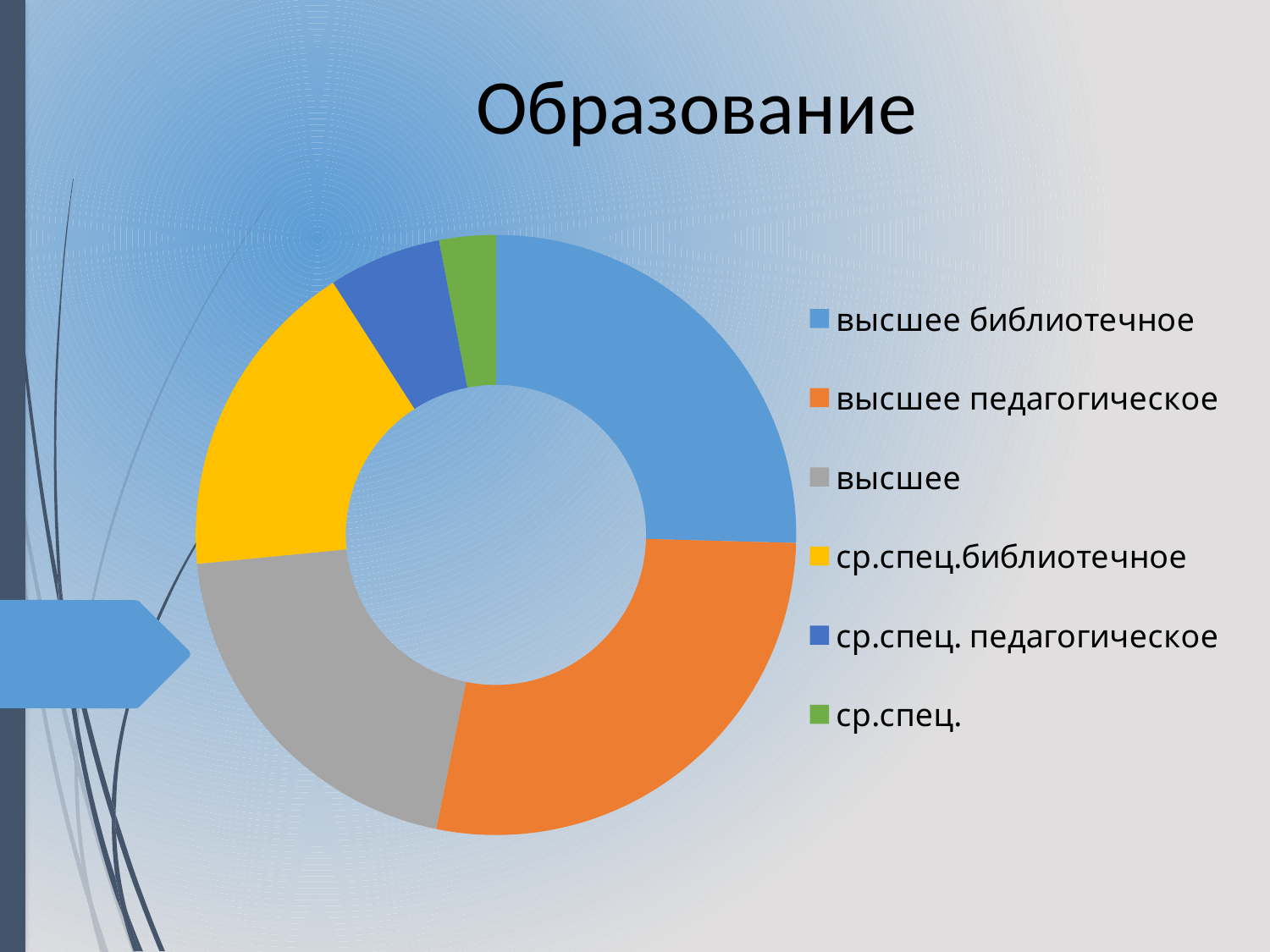
Which slice is larger: высшее педагогическое or высшее? высшее педагогическое What is the title of the chart? Образование What colour represents the category ср.спец.библиотечное in the chart? yellow What kind of chart is shown on the slide? doughnut (pie) chart Which slice is larger: ср.спец. педагогическое or ср.спец.? ср.спец. педагогическое Which slice is larger: высшее or ср.спец. педагогическое? высшее How many categories does the chart's legend list? 6 Which category has the smallest slice in the chart? ср.спец.